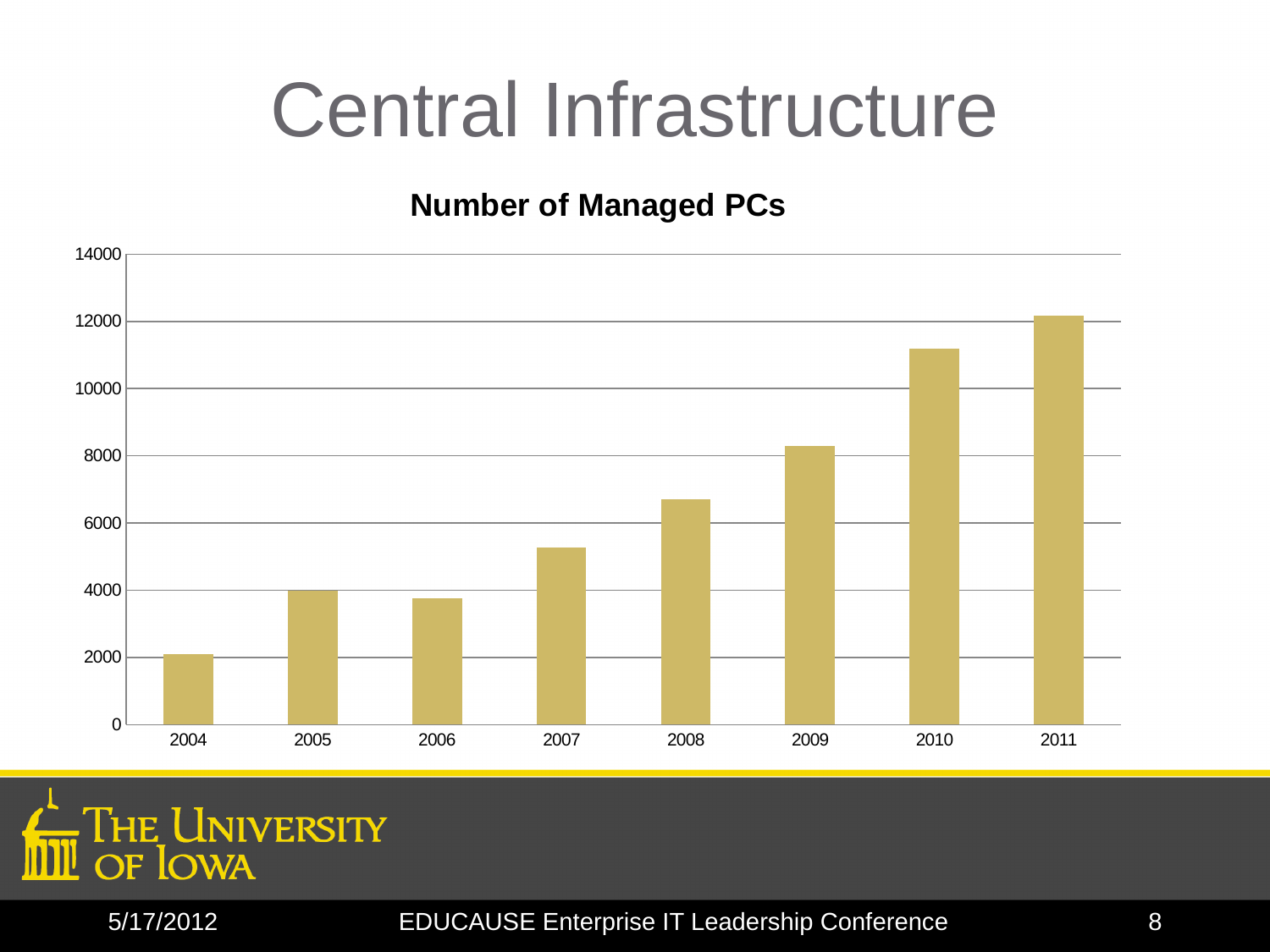
Is the value for 2009 greater or less than 8000? greater Which year has the highest number of managed PCs? 2011 Is the value for 2011 greater or less than 12000? greater What kind of chart is shown on the slide? bar chart Is the value for 2008 greater or less than 8000? less What is the title of the chart? Number of Managed PCs Do the values generally rise or fall from 2004 to 2011? rise Which year has a larger number of managed PCs, 2007 or 2009? 2009 How many years are shown on the x axis of the chart? 8 Which year has the lowest number of managed PCs? 2004